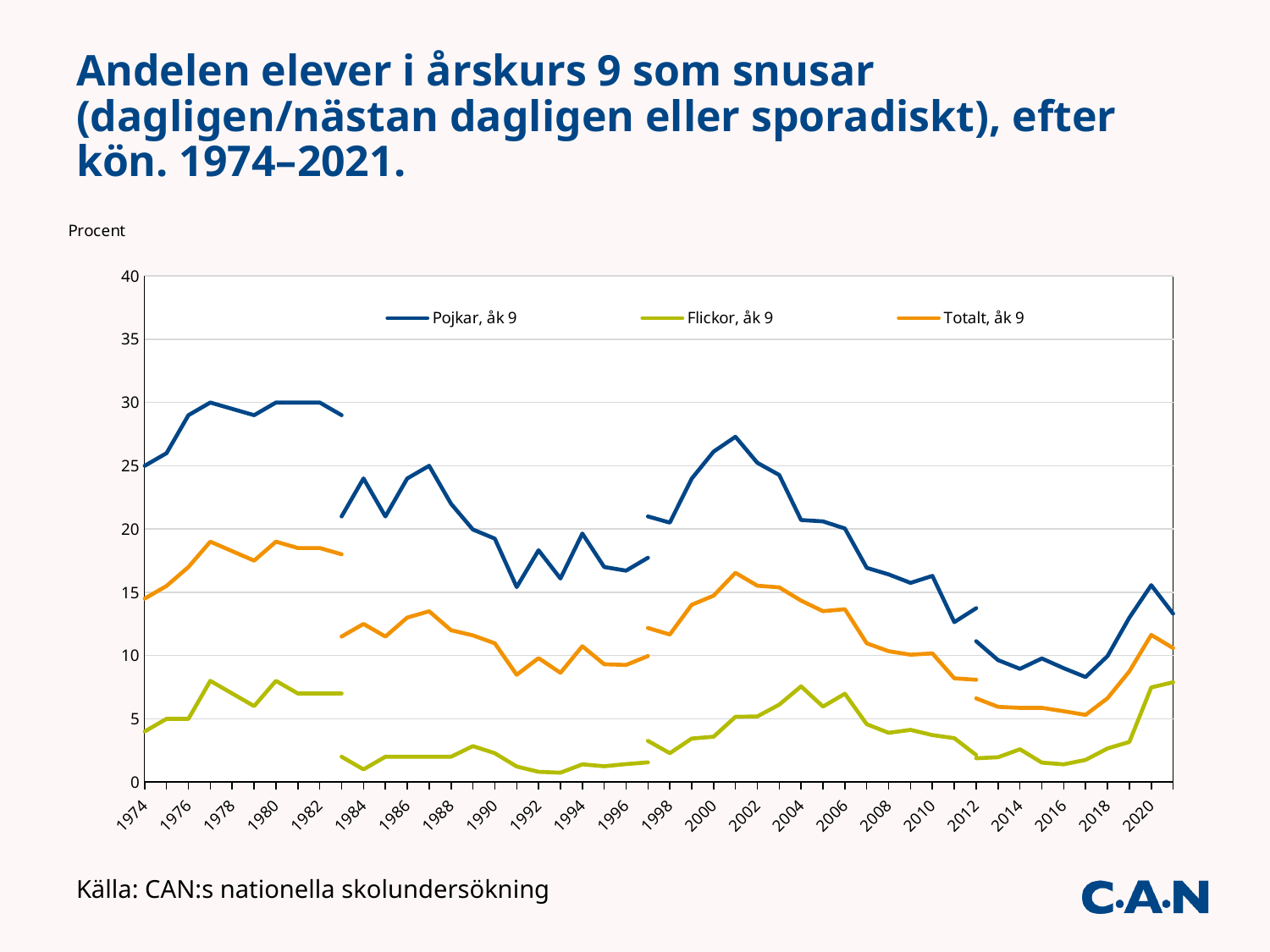
Do the values for Pojkar, åk 9 rise or fall between 2001 and 2012? fall Which series are listed in the legend? Pojkar, åk 9; Flickor, åk 9; Totalt, åk 9 What kind of chart is shown on the slide? line chart How many series does the legend list? 3 Is the value for Flickor, åk 9 in 1974 greater or less than 5? less Is the value for Pojkar, åk 9 in 2021 greater or less than 10? greater Is the value for Pojkar, åk 9 in 2001 greater or less than 25? greater What is the label shown above the vertical axis? Procent Which series has the highest values across the whole period? Pojkar, åk 9 In 2000, which is larger: the value for Pojkar, åk 9 or the value for Flickor, åk 9? Pojkar, åk 9